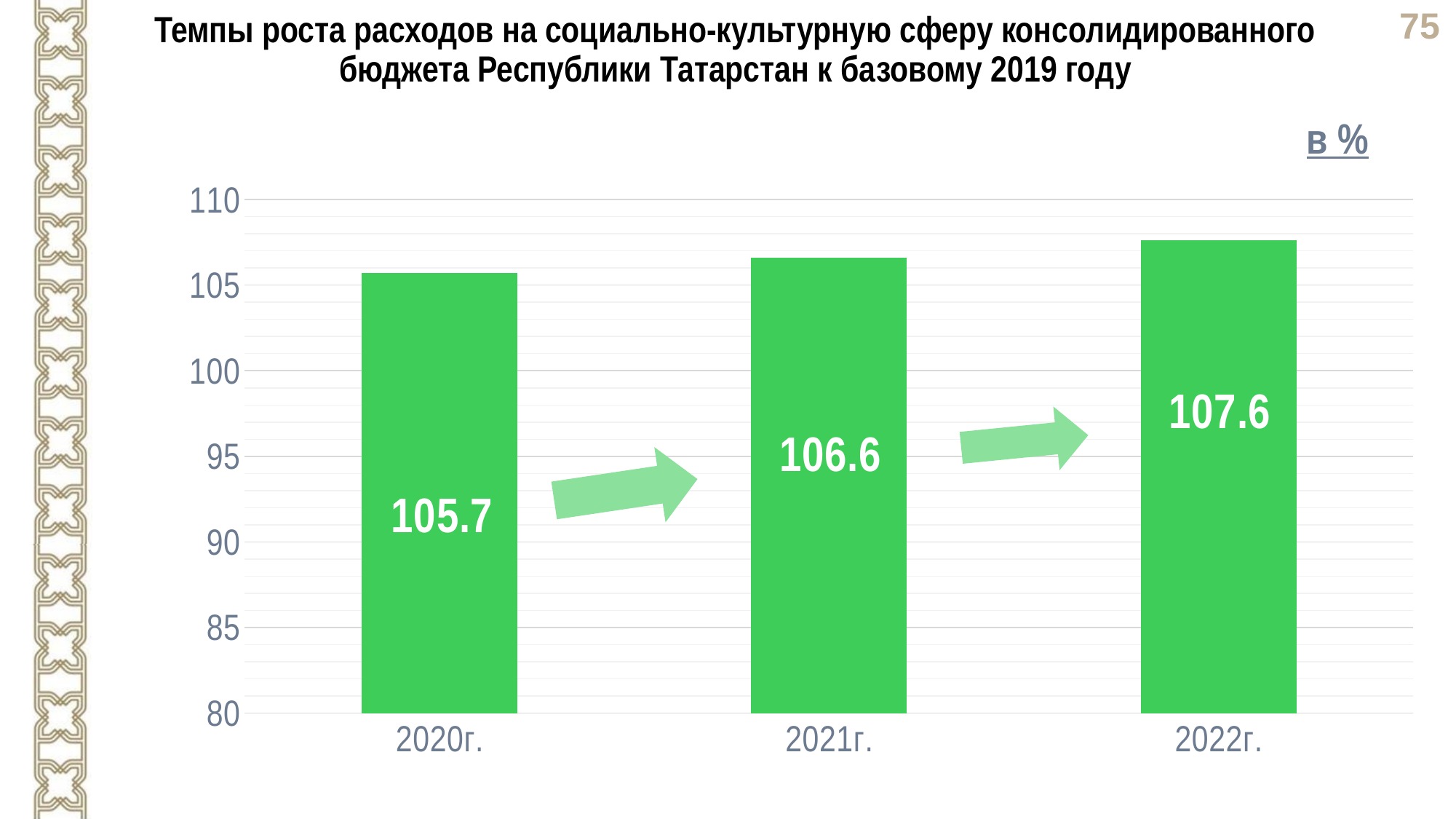
How many years are shown on the chart? 3 What is the difference between the values for 2021г. and 2020г.? 0.9 What is the value for 2022г.? 107.6 Which is larger, the value for 2021г. or the value for 2022г.? 2022г. What kind of chart is shown on the slide? bar chart Is the value for 2020г. greater or less than 105? greater Do the values rise or fall from 2020г. to 2022г.? rise What is the difference between the values for 2022г. and 2020г.? 1.9 What is the value for 2021г.? 106.6 What is the value for 2020г.? 105.7 Which year has the highest value? 2022г. Which year has the lowest value? 2020г.